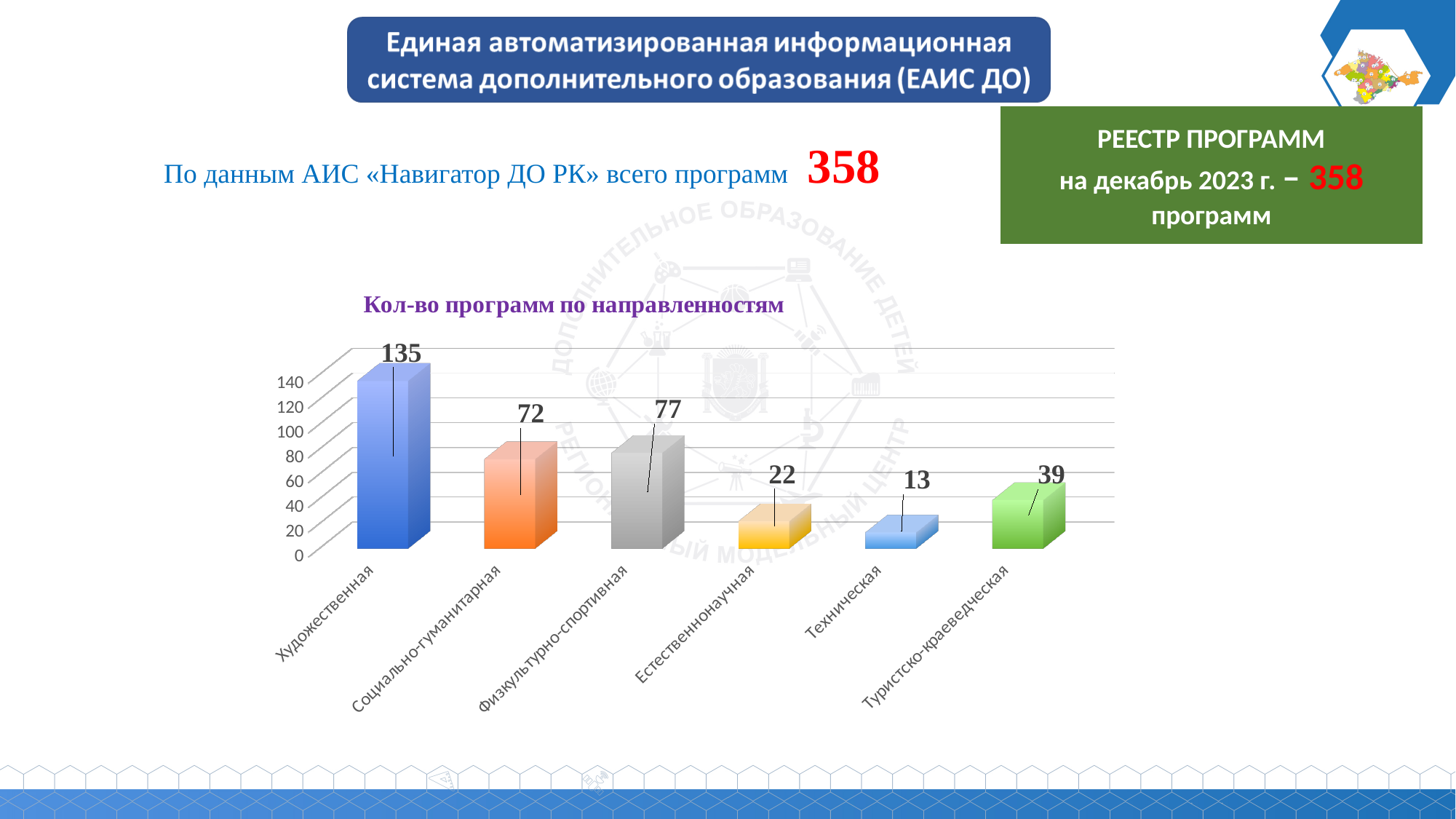
What is the value for Физкультурно-спортивная? 77 What is the title of the chart? Кол-во программ по направленностям What is the value for Техническая? 13 Which category has the lowest value? Техническая What kind of chart is shown on the slide? Bar chart What is the value for Художественная? 135 What is the difference between the values for Туристско-краеведческая and Естественнонаучная? 17 What is the difference between the values for Художественная and Социально-гуманитарная? 63 Which category has the highest value? Художественная What is the value for Туристско-краеведческая? 39 Which is larger, the value for Физкультурно-спортивная or Социально-гуманитарная? Физкультурно-спортивная How many categories are shown in the chart? 6